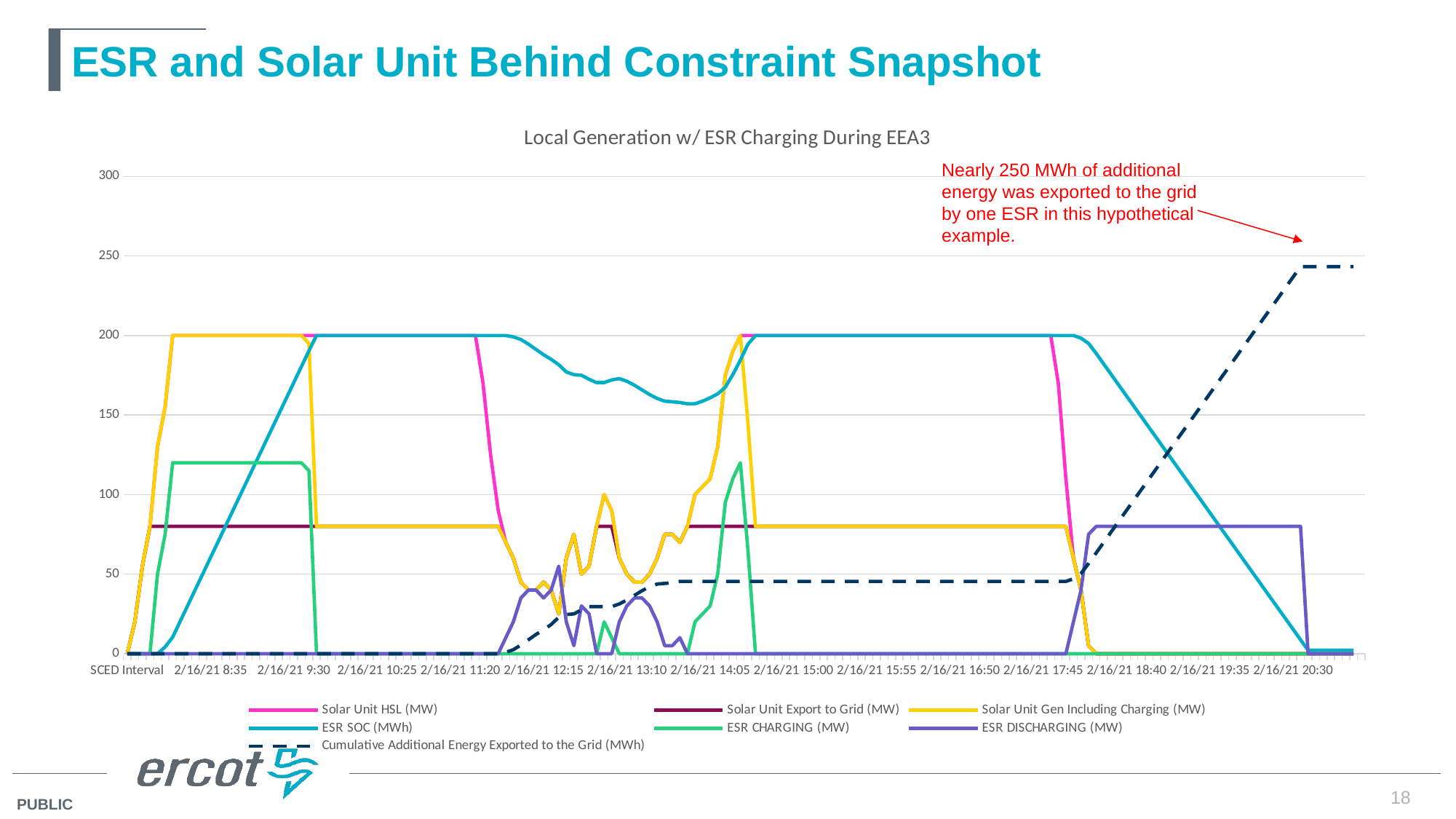
What type of chart is shown on the slide? line chart Is the value of Solar Unit Export to Grid (MW) at 2/16/21 10:25 greater or less than 100? less Which series is drawn as a dashed line? Cumulative Additional Energy Exported to the Grid (MWh) Is the value of ESR DISCHARGING (MW) at 2/16/21 19:35 greater or less than 100? less Is the value of Cumulative Additional Energy Exported to the Grid (MWh) at 2/16/21 20:30 greater or less than 200? greater Does the Cumulative Additional Energy Exported to the Grid (MWh) series rise or fall overall from left to right? rise At 2/16/21 18:40, which is larger: ESR SOC (MWh) or ESR DISCHARGING (MW)? ESR SOC (MWh) What is the maximum value reached by ESR SOC (MWh)? 200 What is the title of the chart? Local Generation w/ ESR Charging During EEA3 How many series does the chart legend list? 7 What is the plateau value of Solar Unit HSL (MW) during the morning, e.g. at 2/16/21 9:30? 200